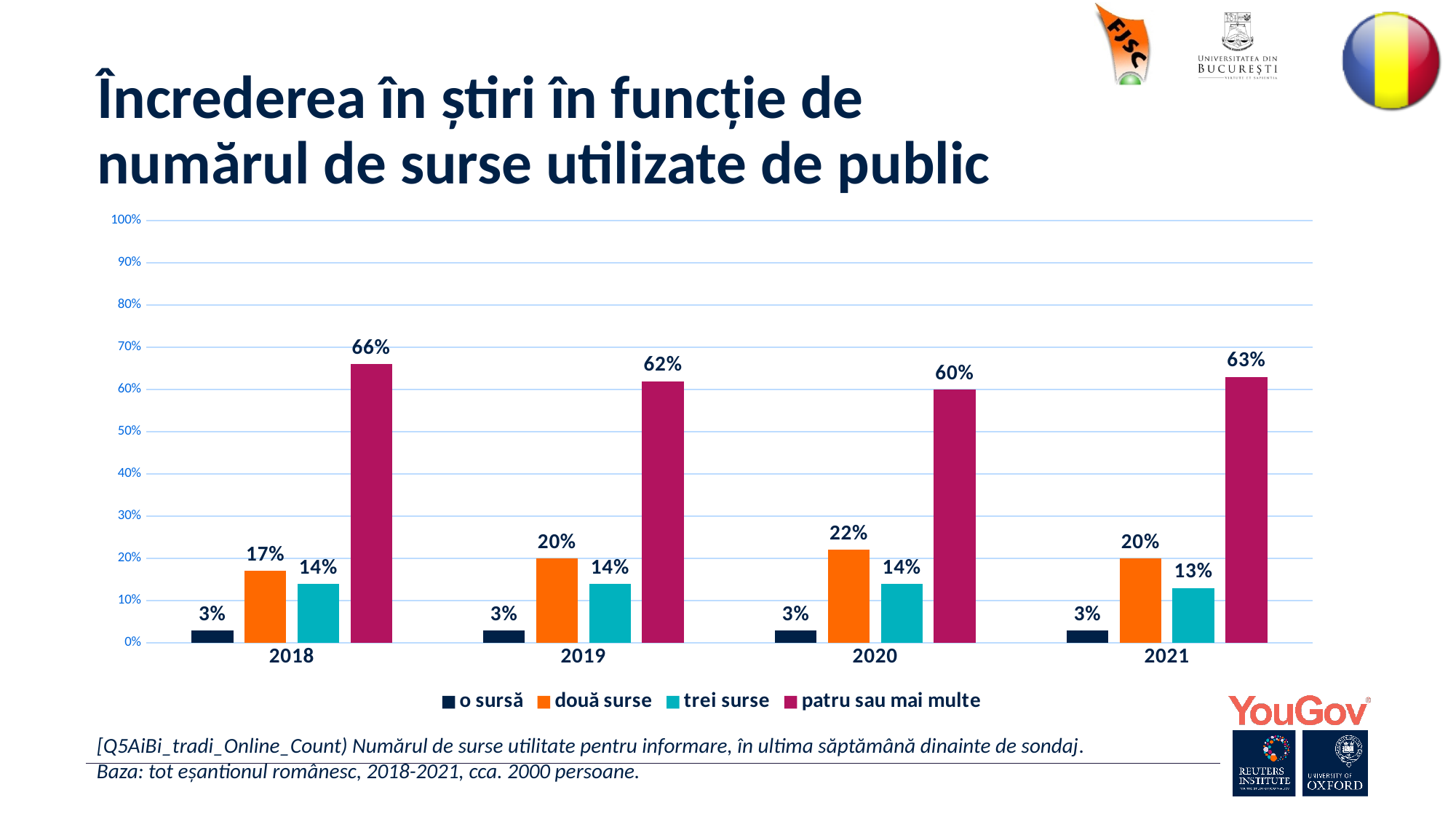
In which year is the value for 'patru sau mai multe' lowest? 2020 What kind of chart is shown on the slide? bar chart What is the value for 'două surse' in 2020? 22% Which is larger in 2019: 'două surse' or 'trei surse'? două surse What is the value for 'o sursă' in 2021? 3% Is the value for 'patru sau mai multe' in 2020 greater or less than 50%? greater How many series does the legend list? 4 How many years are shown on the x axis? 4 In which year is the value for 'patru sau mai multe' highest? 2018 What is the value for 'patru sau mai multe' in 2018? 66% What is the value for 'trei surse' in 2021? 13% What is the difference between the 'patru sau mai multe' values in 2018 and 2021? 3%